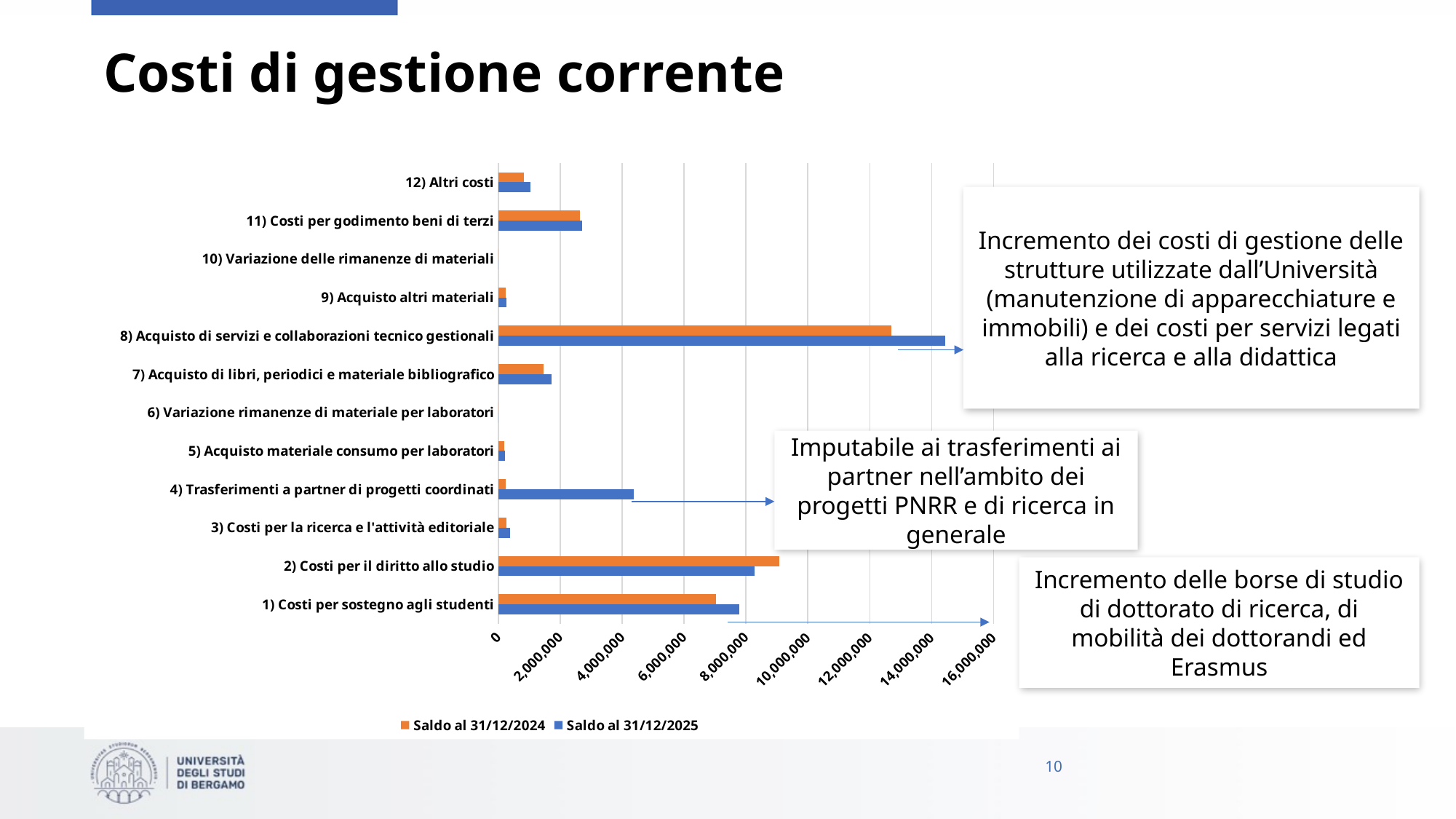
Is the Saldo al 31/12/2024 value for 2) Costi per il diritto allo studio greater or less than 8,000,000? greater For 4) Trasferimenti a partner di progetti coordinati, which series has the larger value: Saldo al 31/12/2024 or Saldo al 31/12/2025? Saldo al 31/12/2025 For 2) Costi per il diritto allo studio, which series has the larger value: Saldo al 31/12/2024 or Saldo al 31/12/2025? Saldo al 31/12/2024 How many series does the chart's legend list? 2 Which category has the highest value for Saldo al 31/12/2024? 8) Acquisto di servizi e collaborazioni tecnico gestionali Which category has the highest value for Saldo al 31/12/2025? 8) Acquisto di servizi e collaborazioni tecnico gestionali What kind of chart is shown on the slide? Bar chart Is the Saldo al 31/12/2025 value for 4) Trasferimenti a partner di progetti coordinati greater or less than 6,000,000? less Is the Saldo al 31/12/2024 value for 7) Acquisto di libri, periodici e materiale bibliografico greater or less than 2,000,000? less Which colour represents the series Saldo al 31/12/2025 in the chart? Blue How many categories are listed on the chart's vertical axis? 12